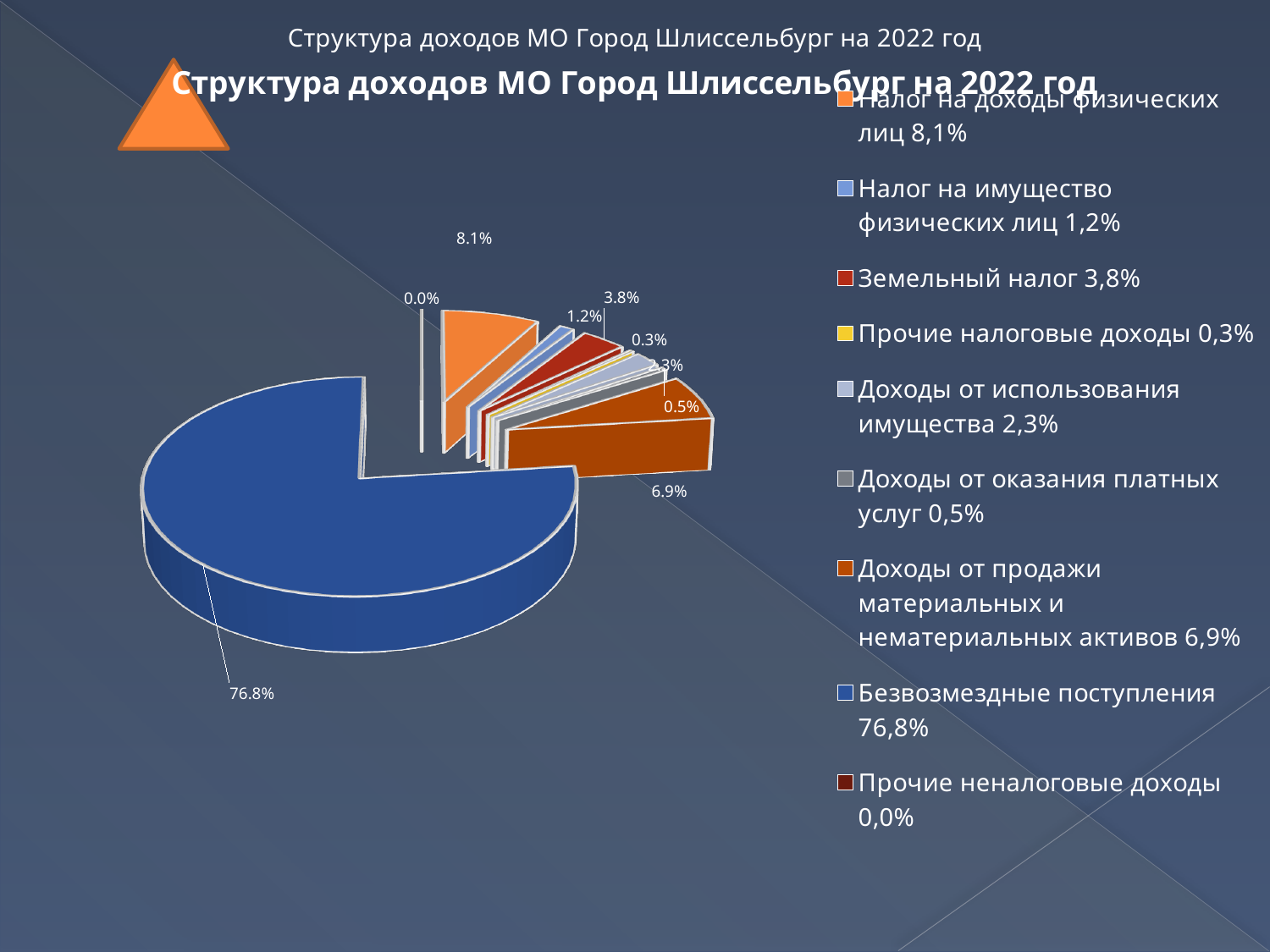
What share of the pie does "Безвозмездные поступления" have? 76.8% What colour is the slice for "Безвозмездные поступления"? blue What is the value shown for "Земельный налог"? 3.8% What is the difference between the share for "Земельный налог" and the share for "Налог на имущество физических лиц"? 2.6% What is the value shown for "Доходы от продажи материальных и нематериальных активов"? 6.9% Which category has the largest share of the pie? Безвозмездные поступления What is the value shown for "Налог на доходы физических лиц"? 8.1% What is the title of the chart? Структура доходов МО Город Шлиссельбург на 2022 год How many categories does the legend of the pie chart list? 9 What kind of chart is shown on the slide? pie chart Which category has the smallest share of the pie? Прочие неналоговые доходы Which is larger: the share for "Налог на доходы физических лиц" or the share for "Доходы от продажи материальных и нематериальных активов"? Налог на доходы физических лиц